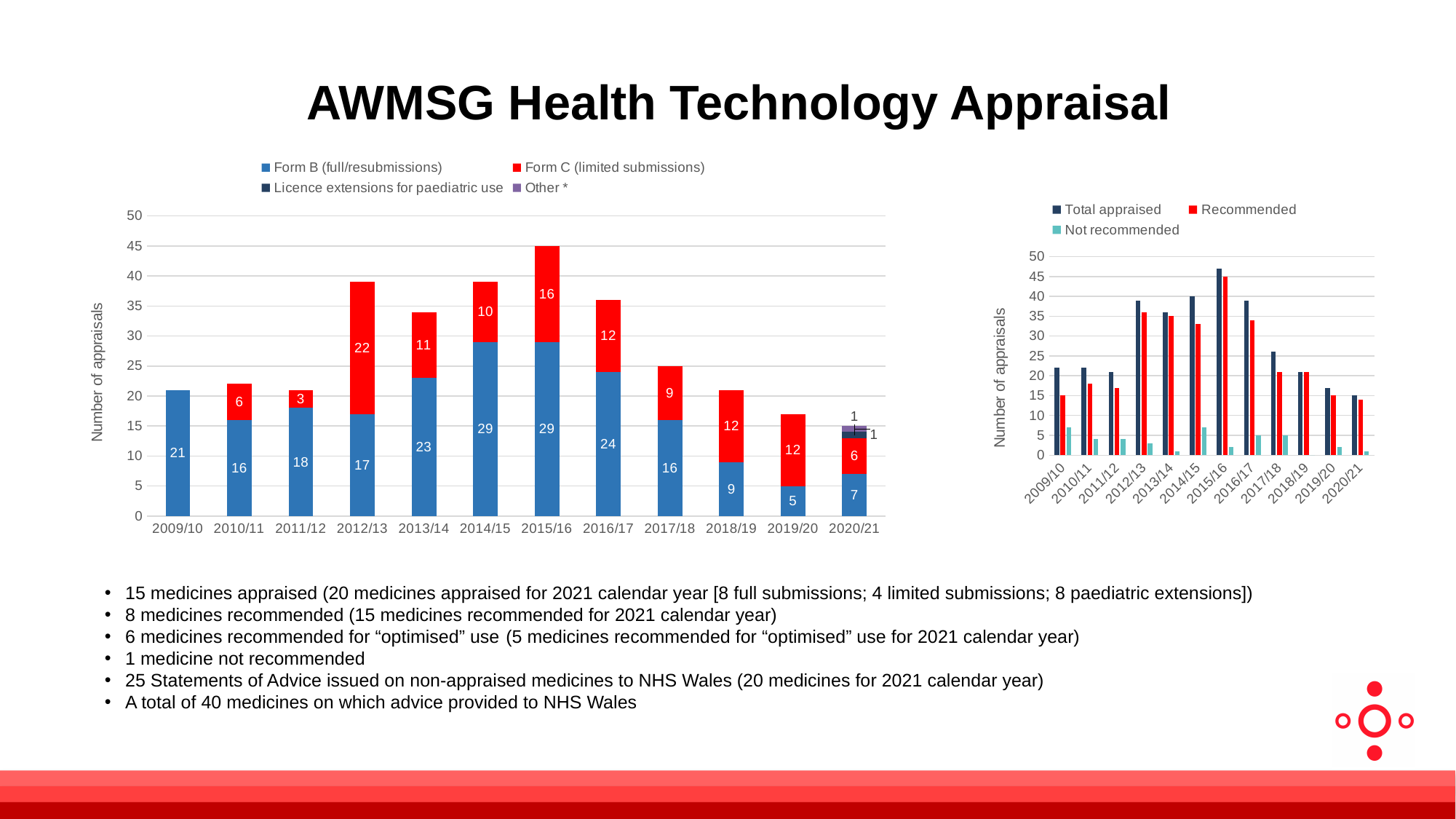
In the left chart, which year has the highest Form C (limited submissions) value? 2012/13 In the left chart, which year has the lowest Form B (full/resubmissions) value? 2019/20 In the left chart, what is the difference between the Form B values for 2013/14 and 2018/19? 14 In the left chart, what is the Form C (limited submissions) value for 2012/13? 22 How many series does the legend of the right chart list? 3 In the left chart, what is the Form B (full/resubmissions) value for 2014/15? 29 In the right chart, is the Total appraised value for 2015/16 greater or less than 45? greater What kind of chart is the right chart? bar chart How many years are shown on the x axis of the left chart? 12 In the left chart, what is the total height of the stacked bar for 2015/16? 45 How many series does the legend of the left chart list? 4 In the left chart, which year has the larger Form C value, 2016/17 or 2017/18? 2016/17